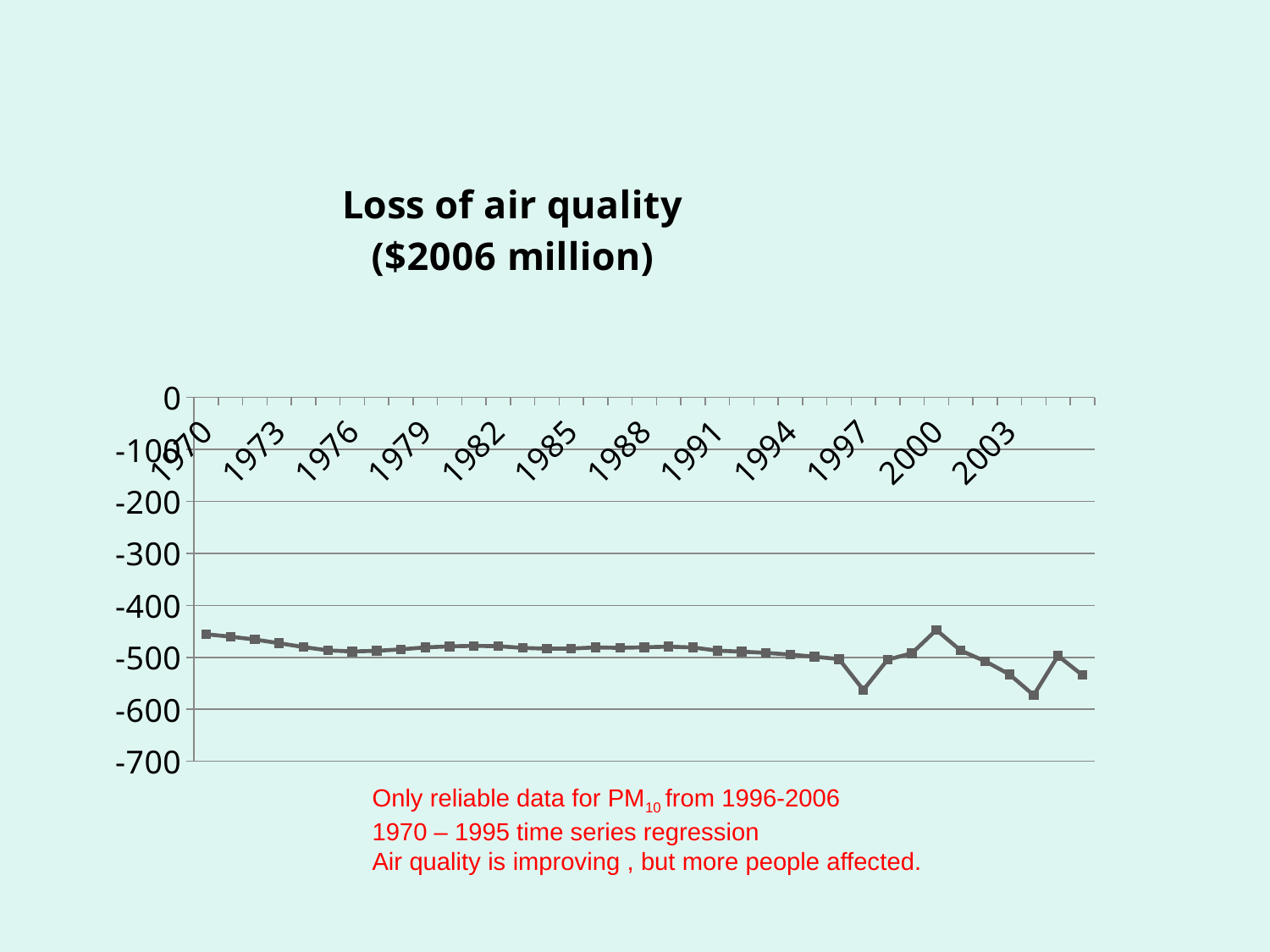
Is the value for 2004 greater or less than -500? less Is the value for 1997 greater or less than -500? less Do the values rise or fall from 1970 to 1977? fall What kind of chart is shown on the slide? line chart Which year has the larger value, 1970 or 2004? 1970 Is the value for 1970 greater or less than -400? less Which year has the larger value, 1997 or 2000? 2000 How many year labels are shown on the x axis? 12 What is the title of the chart? Loss of air quality ($2006 million) What is the lowest tick value shown on the y axis? -700